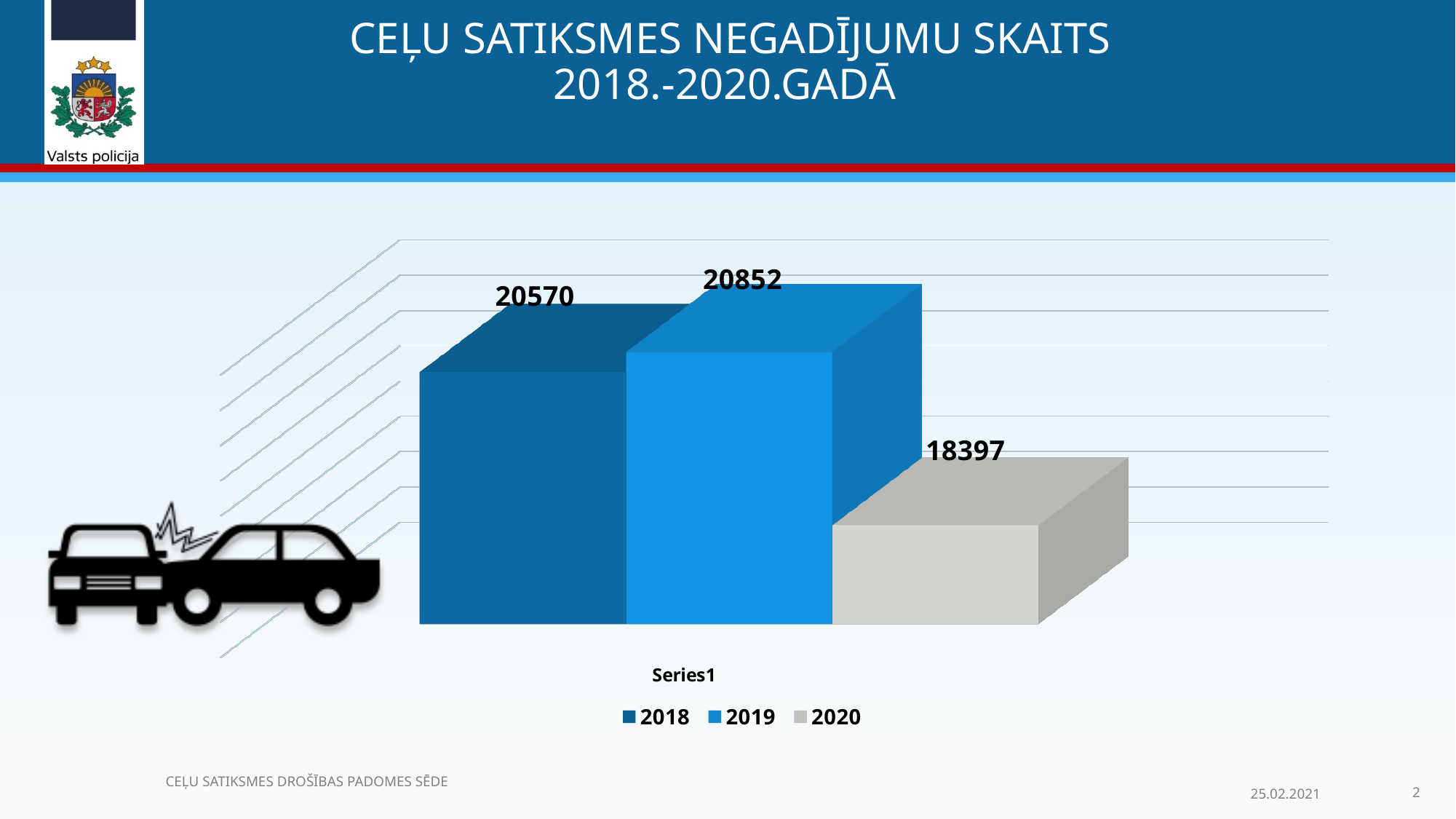
Which year has the lowest value? 2020 Which year has the highest value? 2019 What value is shown for 2019? 20852 Which is larger, the value for 2018 or the value for 2020? 2018 What value is shown for 2020? 18397 How many series does the legend list? 3 By how much is the 2019 value greater than the 2020 value? 2455 What kind of chart is shown on the slide? Bar chart What is the number of road traffic accidents shown for 2018? 20570 What is the difference between the 2018 and 2020 values? 2173 What is the title of the chart on the slide? CEĻU SATIKSMES NEGADĪJUMU SKAITS 2018.-2020.GADĀ What is the difference between the 2019 and 2018 values? 282